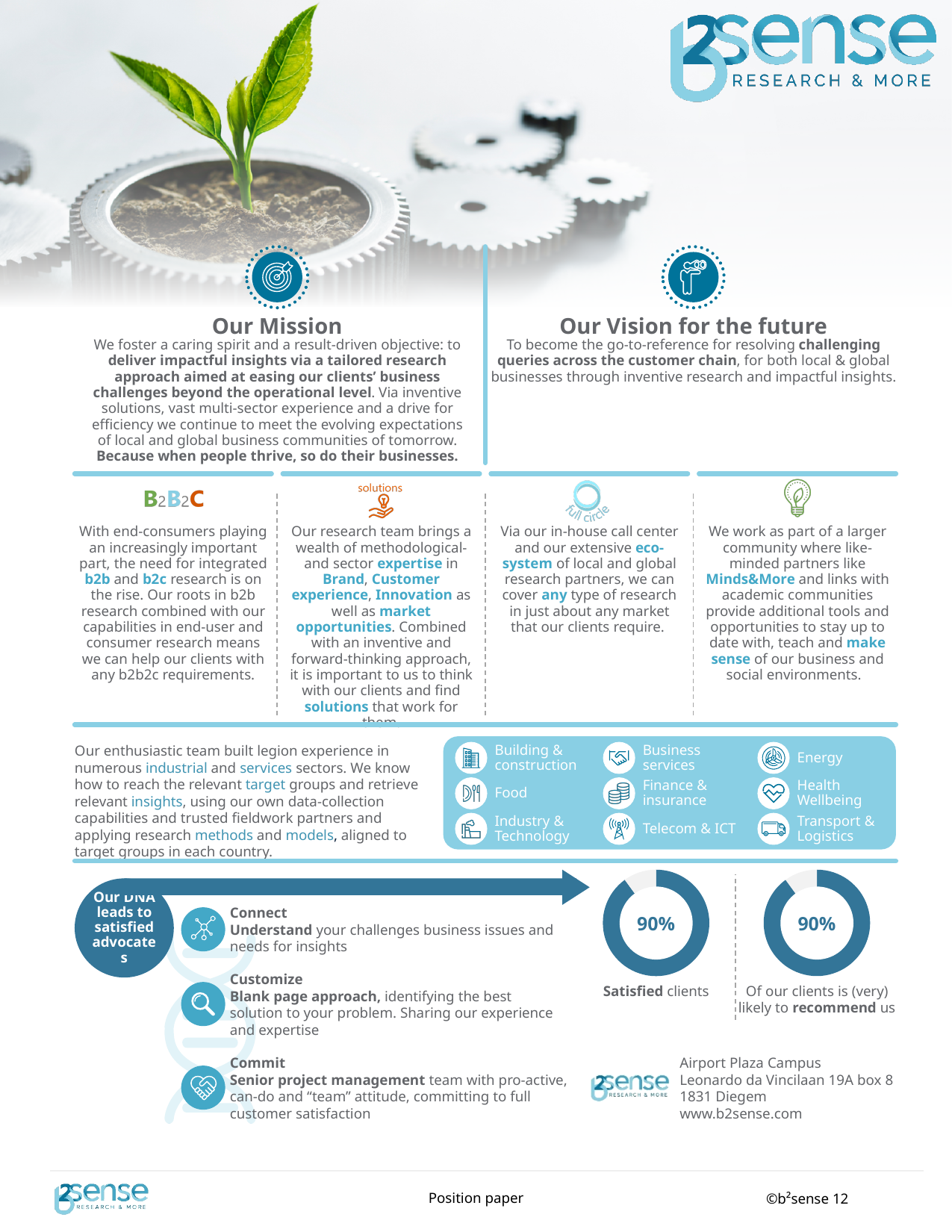
What kind of chart is used to show the 'Satisfied clients' figure? Donut (doughnut) chart On the right donut chart, is the value shown greater or less than 50%? greater On the left donut chart, what share of the ring is filled by the dark blue segment? 90% What is the label printed beneath the right donut chart? Of our clients is (very) likely to recommend us On the left donut chart, what percentage of clients are satisfied? 90% What is the label printed beneath the left donut chart? Satisfied clients On the right donut chart, what percentage of clients is (very) likely to recommend the company? 90% How many donut charts are shown on the slide? 2 Do the two donut charts show the same percentage value? Yes, both show 90%